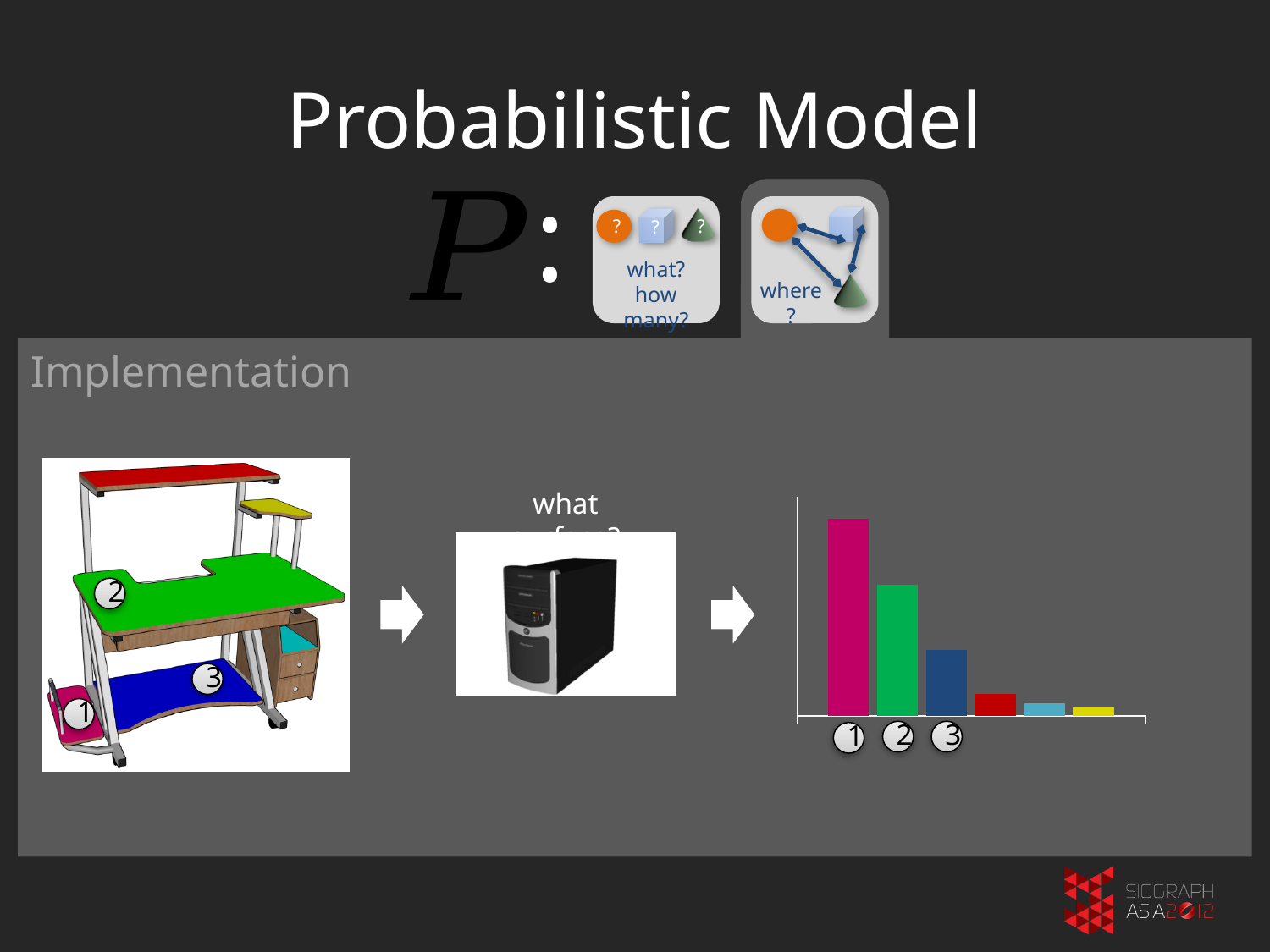
What kind of chart is shown on the slide? bar chart Which bar is taller, category 2 or category 3? 2 Which of the labelled categories (1, 2 or 3) has the shortest bar? 3 Which of the labelled categories (1, 2 or 3) has the tallest bar? 1 Which bar is taller, category 1 or category 2? 1 What colour is the bar for category 1? magenta Do the bar heights rise or fall from left to right across the chart? fall How many bars does the chart contain? 6 What colour is the bar for category 2? green How many bars in the chart have a numbered label beneath them? 3